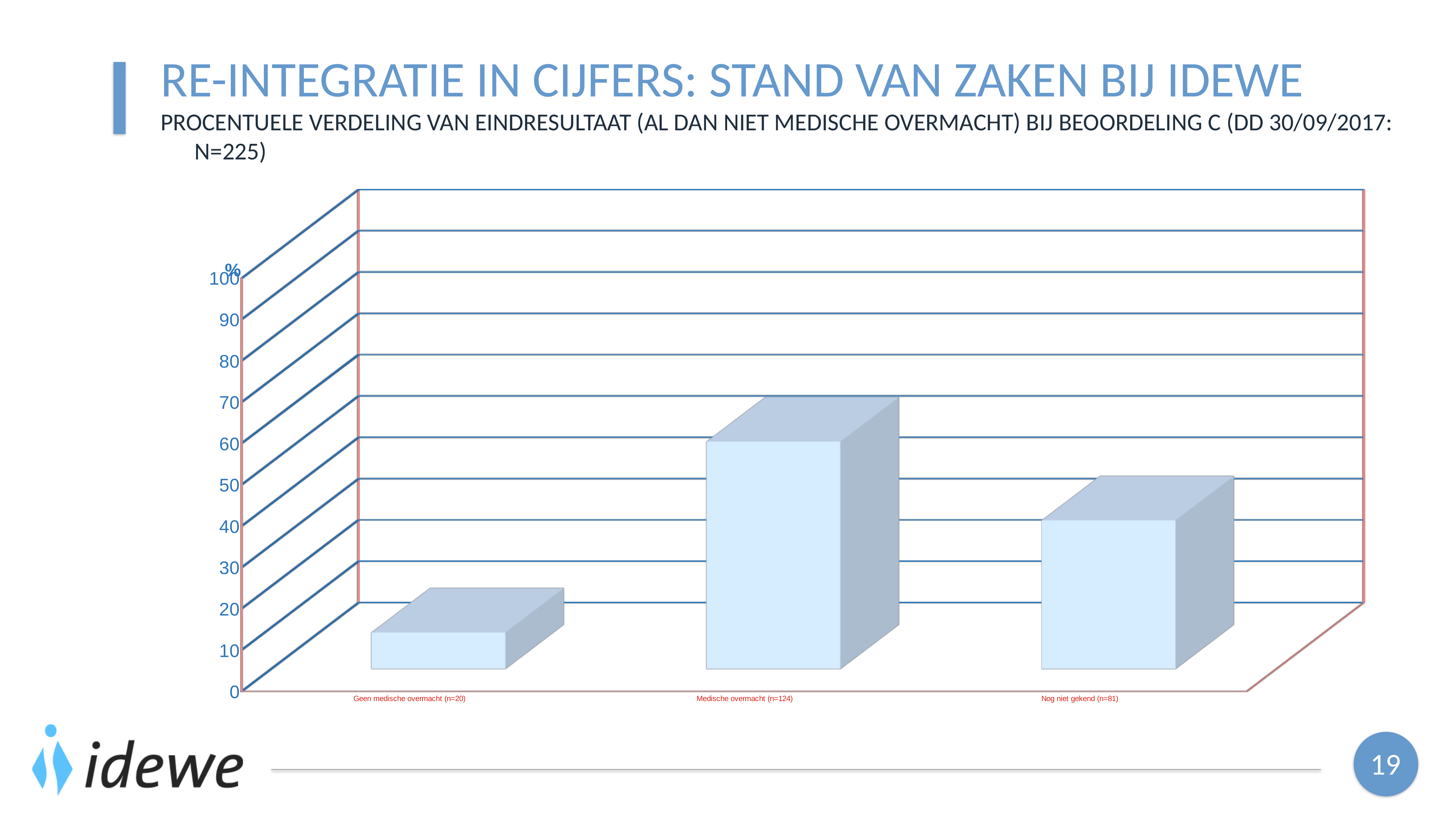
Is the value for Nog niet gekend greater or less than 20? greater What is the total N stated in the chart subtitle? N=225 Is the value for Geen medische overmacht greater or less than 30? less Is the value for Medische overmacht greater or less than 80? less Which is larger, the value for Medische overmacht or the value for Nog niet gekend? Medische overmacht What unit is shown on the vertical axis of the chart? % Which is larger, the value for Geen medische overmacht or the value for Nog niet gekend? Nog niet gekend Which category has the lowest bar? Geen medische overmacht (n=20) Which category has the highest bar? Medische overmacht (n=124) What kind of chart is shown on the slide? bar chart How many categories are shown on the x axis of the chart? 3